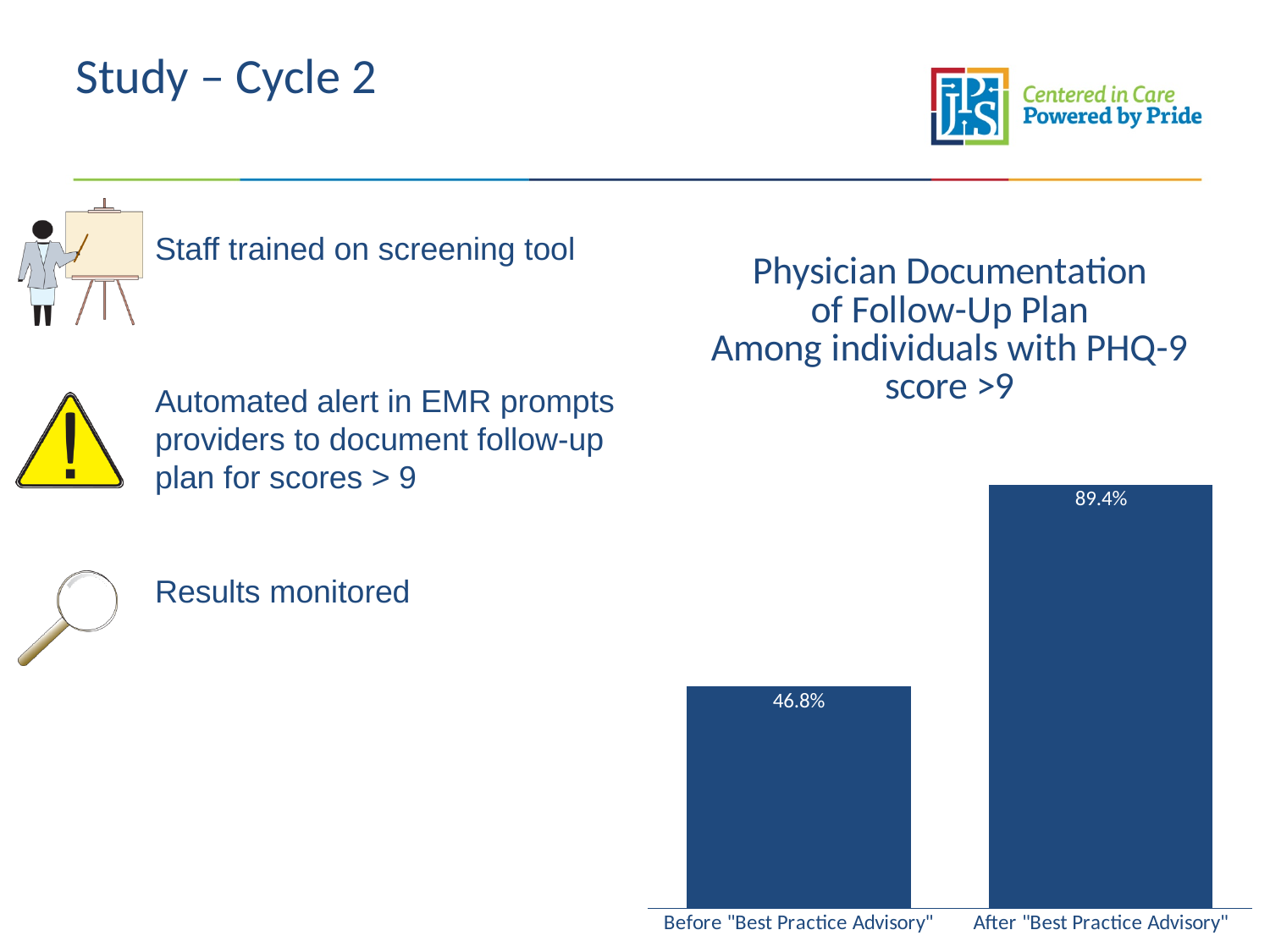
What is the difference between the After "Best Practice Advisory" value and the Before "Best Practice Advisory" value? 42.6% What colour are the bars in the chart? Dark blue Which category has the highest value? After "Best Practice Advisory" How many categories are shown in the chart? 2 What kind of chart is shown on the slide? Bar chart Which category has the lowest value? Before "Best Practice Advisory" Do the values rise or fall from the Before category to the After category? Rise What is the title of the chart? Physician Documentation of Follow-Up Plan Among individuals with PHQ-9 score >9 What is the value for After "Best Practice Advisory"? 89.4% Which is larger, the value for Before "Best Practice Advisory" or After "Best Practice Advisory"? After "Best Practice Advisory" What is the value for Before "Best Practice Advisory"? 46.8%